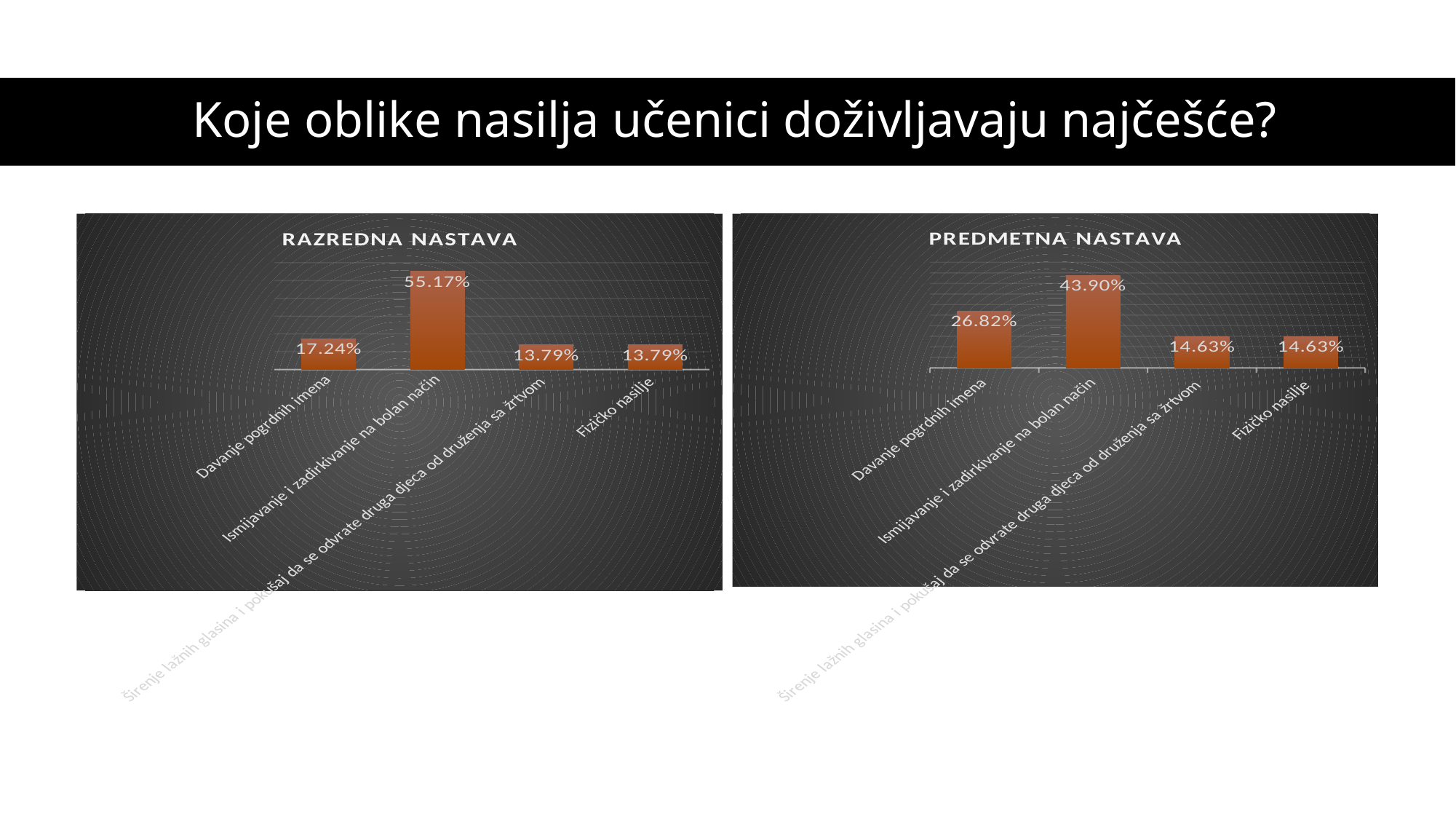
In the PREDMETNA NASTAVA chart, what is the value for Fizičko nasilje? 14.63% In the PREDMETNA NASTAVA chart, which is larger: the value for Davanje pogrdnih imena or the value for Fizičko nasilje? Davanje pogrdnih imena In the RAZREDNA NASTAVA chart, which category has the highest value? Ismijavanje i zadirkivanje na bolan način In the PREDMETNA NASTAVA chart, what is the difference between the values for Ismijavanje i zadirkivanje na bolan način and Davanje pogrdnih imena? 17.08% What is the title of the chart on the left side of the slide? RAZREDNA NASTAVA In the RAZREDNA NASTAVA chart, what is the difference between the values for Ismijavanje i zadirkivanje na bolan način and Davanje pogrdnih imena? 37.93% In the RAZREDNA NASTAVA chart, what is the value for Ismijavanje i zadirkivanje na bolan način? 55.17% What kind of chart is the PREDMETNA NASTAVA chart? Bar chart In the PREDMETNA NASTAVA chart, what is the value for Davanje pogrdnih imena? 26.82% In the PREDMETNA NASTAVA chart, which category has the highest value? Ismijavanje i zadirkivanje na bolan način In the RAZREDNA NASTAVA chart, what is the value for Davanje pogrdnih imena? 17.24% How many categories are shown in the RAZREDNA NASTAVA chart? 4